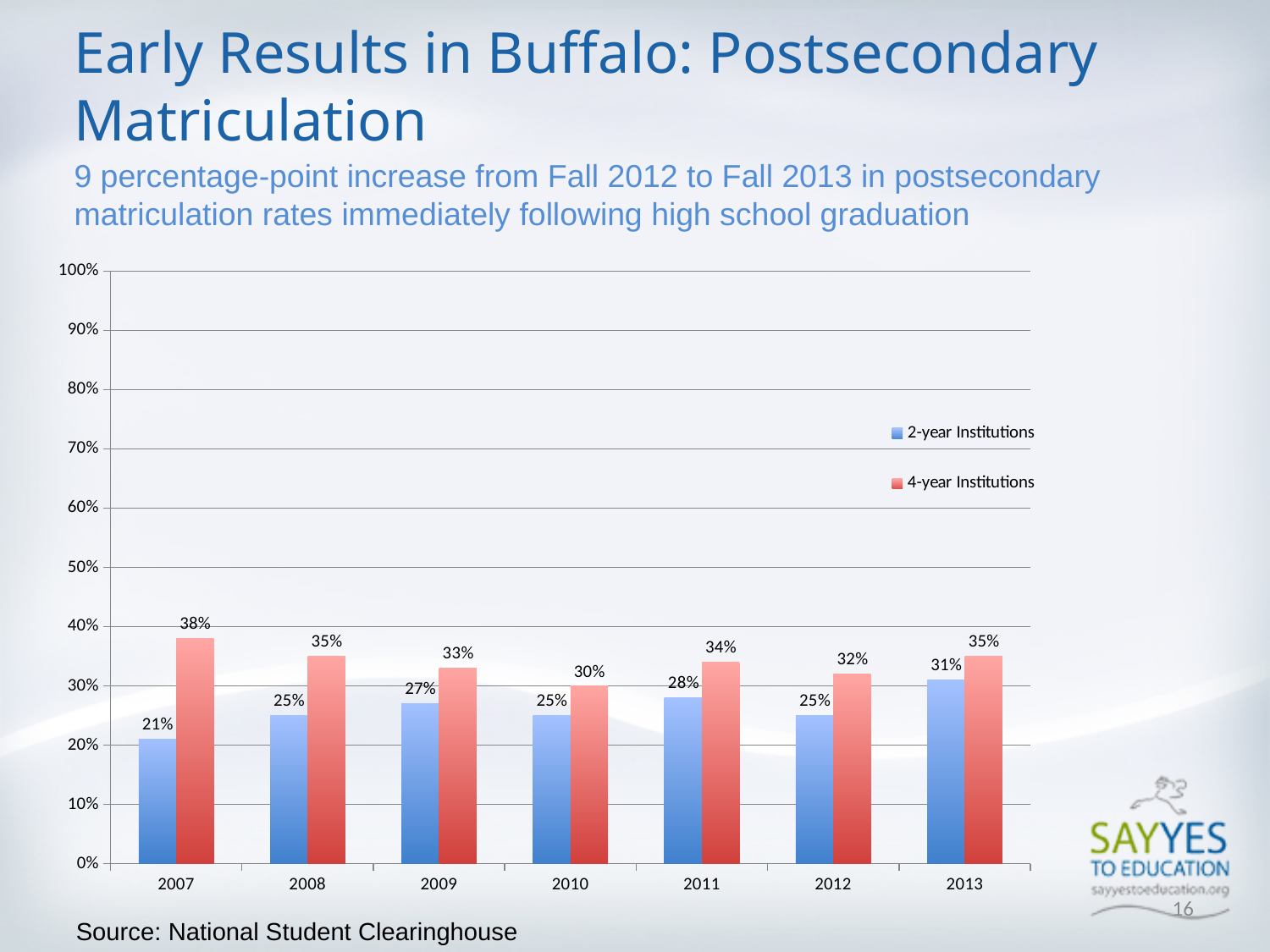
How many years are shown on the x axis? 7 Which year has the lowest value for 2-year Institutions? 2007 Which is larger in 2011: the value for 2-year Institutions or 4-year Institutions? 4-year Institutions What is the value for 4-year Institutions in 2010? 30% What is the value for 2-year Institutions in 2007? 21% Which year has the highest value for 4-year Institutions? 2007 Does the value for 2-year Institutions rise or fall from 2012 to 2013? Rise What kind of chart is shown on the slide? Bar chart How many series does the legend list? 2 What is the difference between the 4-year Institutions and 2-year Institutions values in 2007? 17% Which colour represents 4-year Institutions in the legend? Red What is the value for 4-year Institutions in 2013? 35%